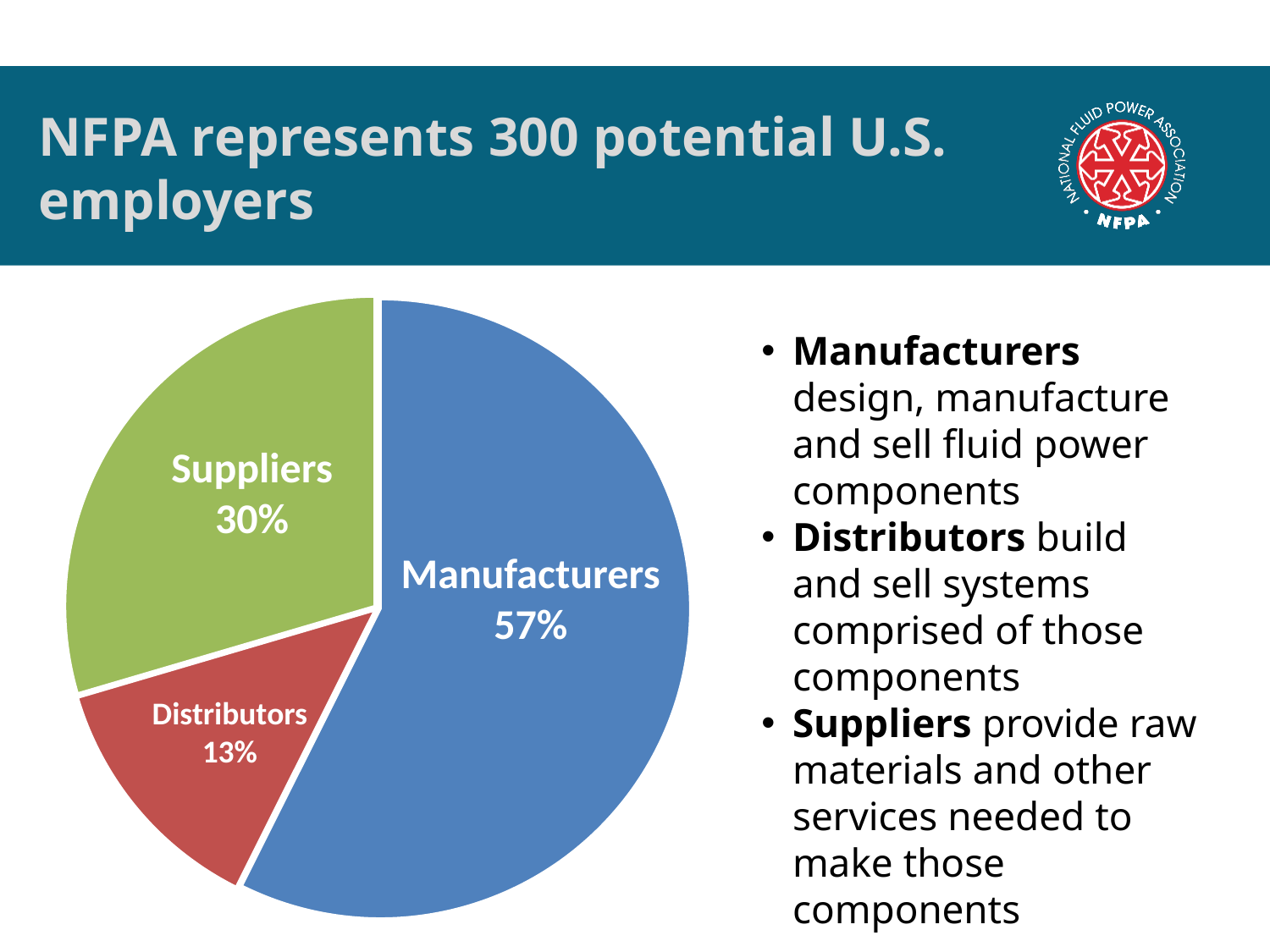
Which category has the smallest slice of the pie? Distributors What kind of chart is shown on the slide? Pie chart What colour is the Distributors slice? Red How many slices does the pie chart have? 3 What share of the pie do Distributors represent? 13% Which category has the largest slice of the pie? Manufacturers What is the difference in percentage points between Manufacturers and Suppliers? 27 What share of the pie do Suppliers represent? 30% What is the difference in percentage points between Suppliers and Distributors? 17 Which is larger, the Suppliers slice or the Distributors slice? Suppliers What colour is the Manufacturers slice? Blue What share of the pie do Manufacturers represent? 57%